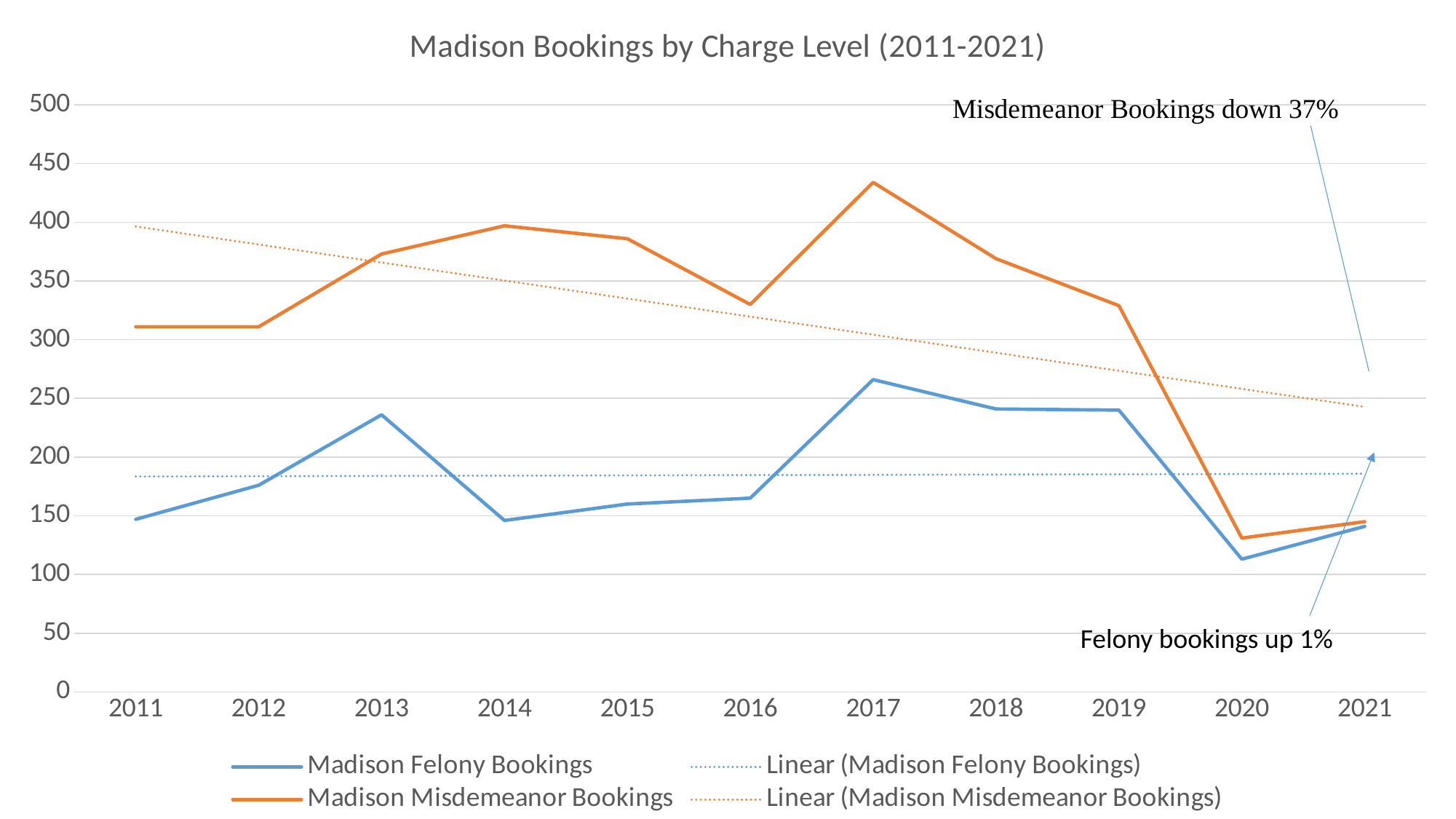
In which year were Madison Misdemeanor Bookings highest? 2017 How many years are shown along the x axis? 11 What kind of chart is shown on the slide? Line chart According to the annotation on the chart, by what percentage are Misdemeanor Bookings down? 37% Is the value for Madison Misdemeanor Bookings in 2017 greater or less than 400? greater Which is larger: Madison Misdemeanor Bookings in 2014 or in 2016? 2014 Is the value for Madison Felony Bookings in 2020 greater or less than 150? less Does the Linear (Madison Misdemeanor Bookings) trendline rise or fall from 2011 to 2021? Fall In which year were Madison Felony Bookings highest? 2017 In which year were Madison Felony Bookings lowest? 2020 Is the value for Madison Misdemeanor Bookings in 2014 greater or less than 350? greater How many entries does the legend list? 4